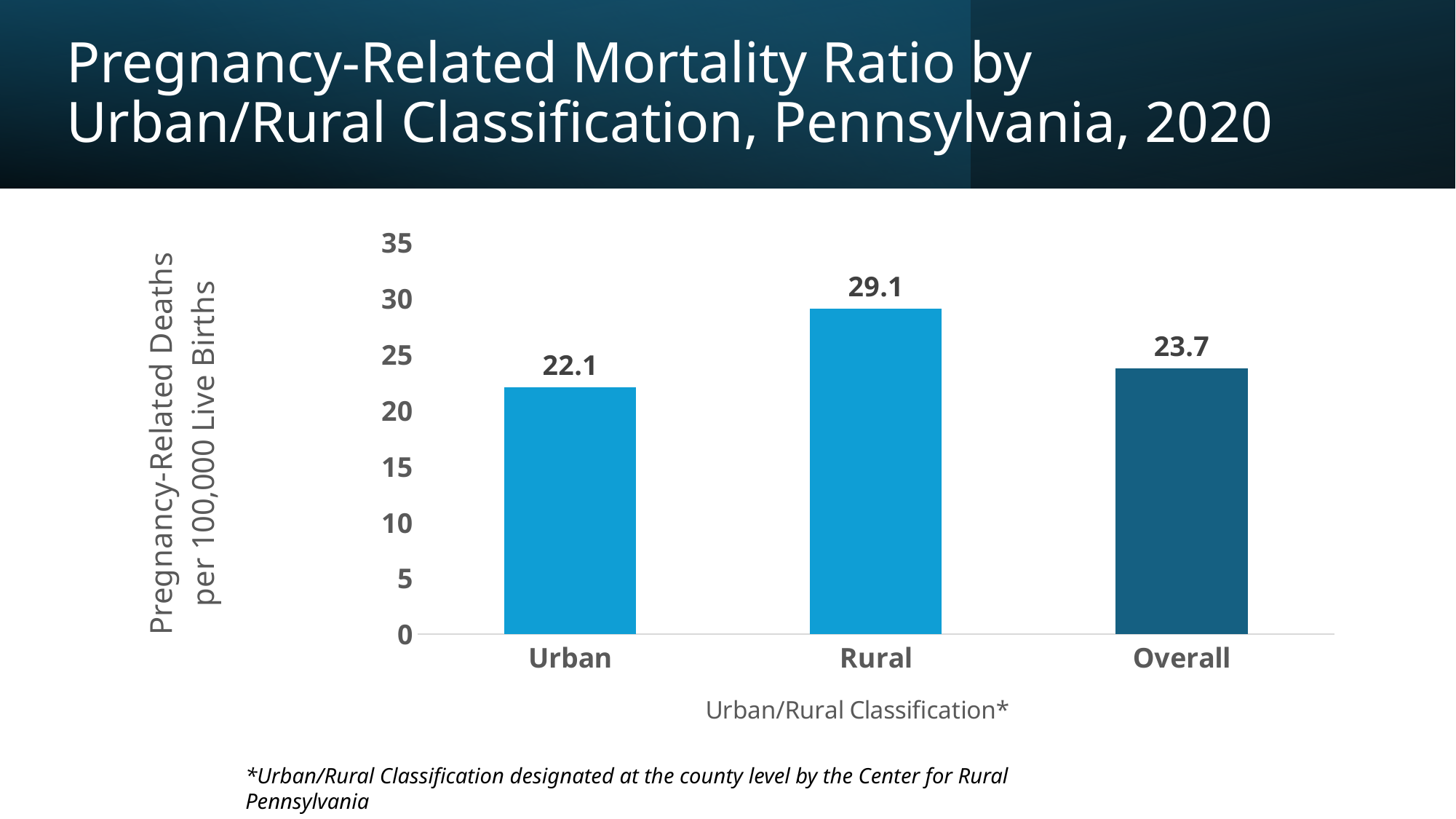
What is the pregnancy-related mortality ratio for Rural counties? 29.1 What is the difference between the Overall and Urban pregnancy-related mortality ratios? 1.6 What is the difference between the Rural and Urban pregnancy-related mortality ratios? 7.0 Is the value for Rural greater or less than 25? greater What is the Overall pregnancy-related mortality ratio shown on the chart? 23.7 Which is larger, the Rural value or the Overall value? Rural Which classification has the highest pregnancy-related mortality ratio? Rural What kind of chart is shown on the slide? Bar chart Which classification has the lowest pregnancy-related mortality ratio? Urban What is the pregnancy-related mortality ratio for Urban counties? 22.1 How many categories are shown on the x axis of the chart? 3 What is the label of the y axis of the chart? Pregnancy-Related Deaths per 100,000 Live Births